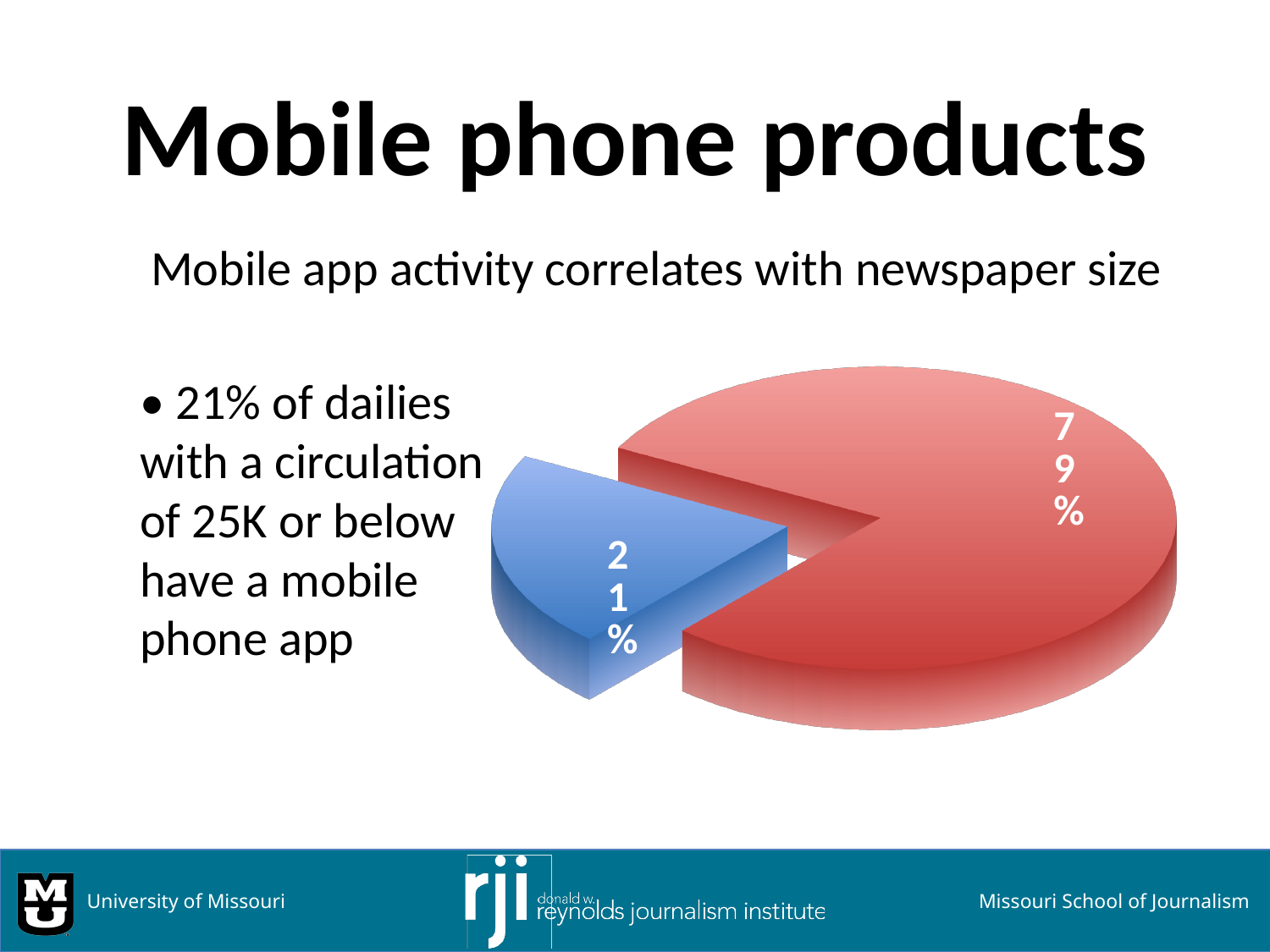
What kind of chart is shown on the slide? pie chart How many slices does the pie chart have? 2 Which slice of the pie chart is the largest? the red slice (79%) What share of the pie does the blue slice represent? 21% What do the two slices of the pie chart add up to? 100% What percentage is shown on the blue slice of the pie chart? 21% What is the title of the slide containing the pie chart? Mobile phone products By how many percentage points does the red slice exceed the blue slice? 58 percentage points Which is larger, the red slice or the blue slice? the red slice What percentage is shown on the red slice of the pie chart? 79% Is the blue slice's share greater or less than 50%? less Which slice of the pie chart is the smallest? the blue slice (21%)